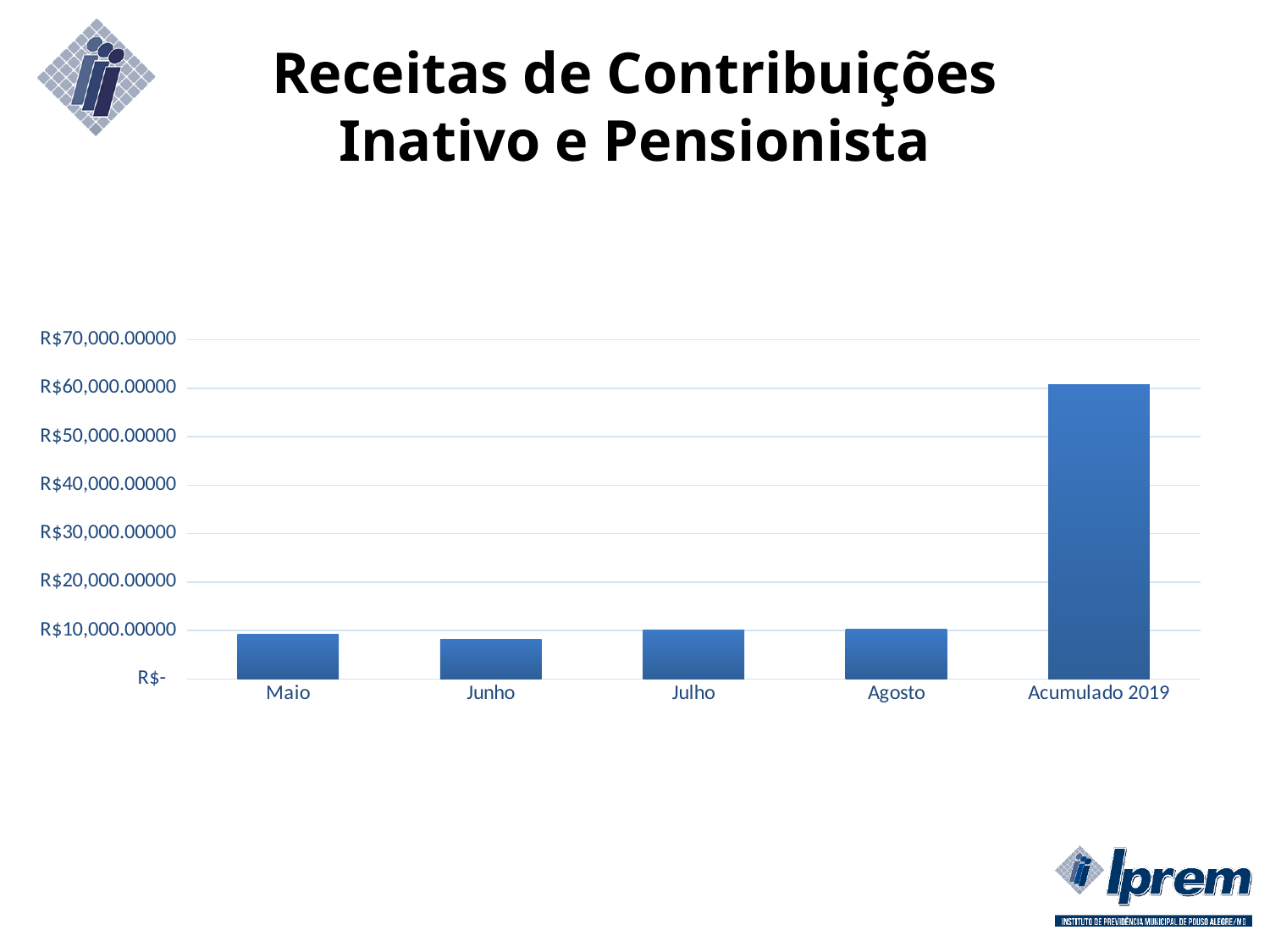
Which category has the highest value in the chart? Acumulado 2019 What is the highest value shown on the vertical axis of the chart? R$70,000.00000 Is the value for Junho greater or less than R$10,000.00000? less Which category has the lowest value in the chart? Junho Which is larger, the value for Julho or the value for Junho? Julho What kind of chart is shown on the slide? bar chart Is the value for Acumulado 2019 greater or less than R$50,000.00000? greater What is the title of the slide containing the chart? Receitas de Contribuições Inativo e Pensionista Is the value for Acumulado 2019 greater or less than R$70,000.00000? less How many categories are shown on the x axis of the chart? 5 Which is larger, the value for Maio or the value for Junho? Maio